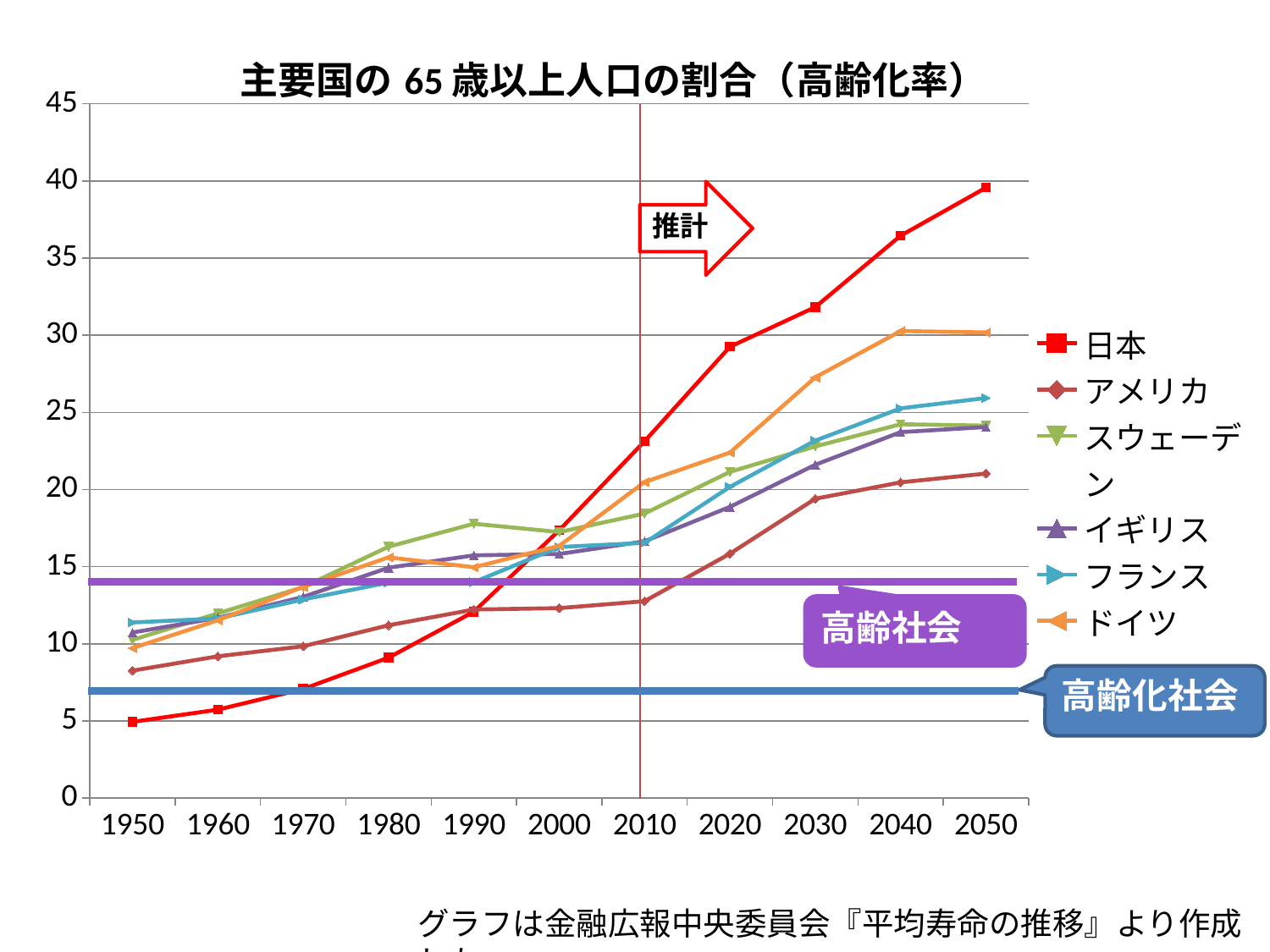
How many series does the legend list? 6 Is the value for 日本 in 2050 greater or less than 35? greater Does the line for 日本 rise or fall from 1950 to 2050? rise Is the value for 日本 in 1950 greater or less than 10? less In 2020, which is larger: the value for 日本 or the value for ドイツ? 日本 What is the title of the chart? 主要国の65歳以上人口の割合（高齢化率） Which country has the lowest value in 2050? アメリカ What kind of chart is shown on the slide? line chart Which country has the lowest value in 1950? 日本 Is the value for アメリカ in 2050 greater or less than 25? less Which country has the highest value in 2050? 日本 How many years are marked along the x axis? 11